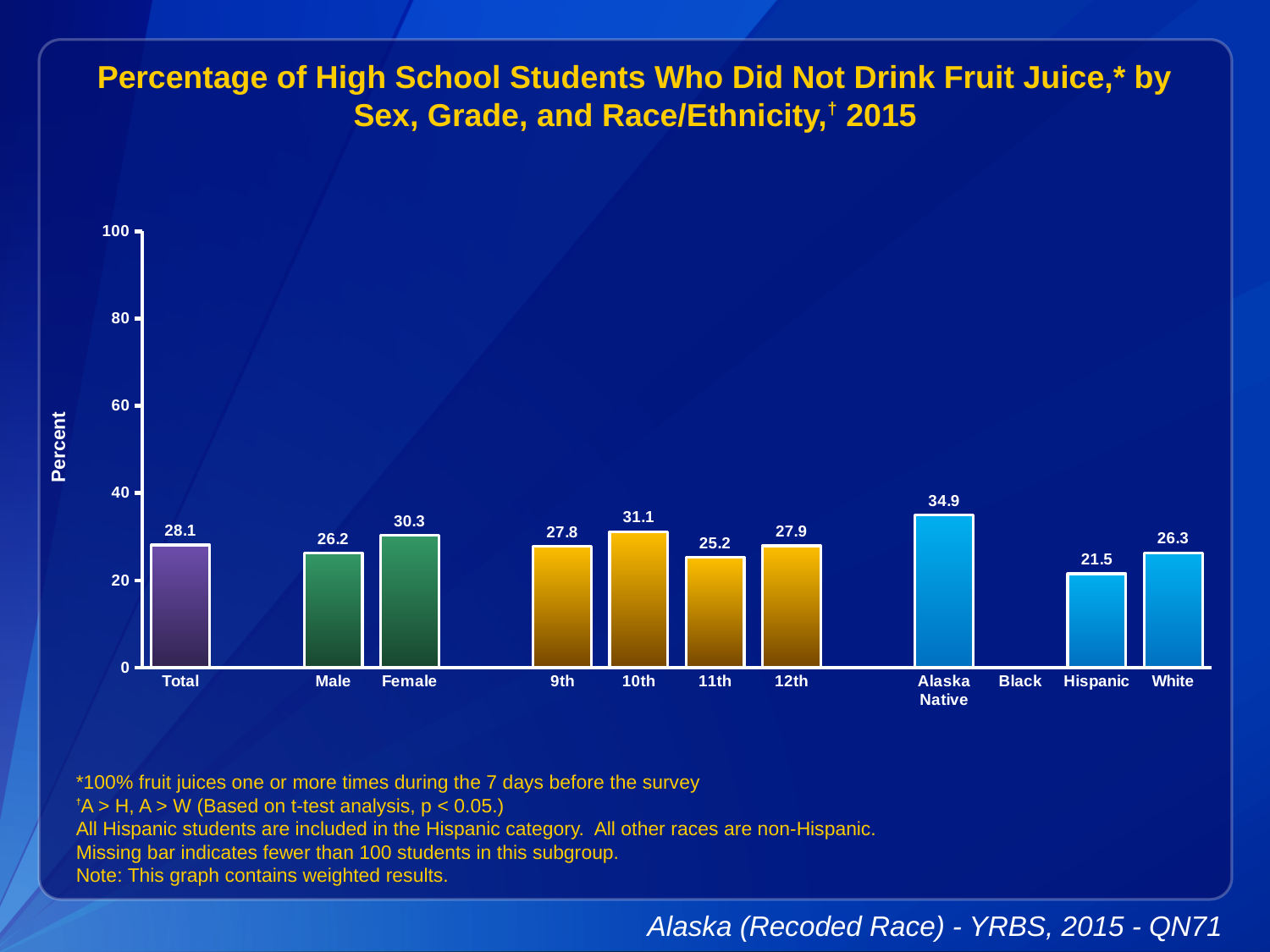
Is the value for White greater or less than 40? less What kind of chart is shown? bar chart What is the difference between the Female and Male values? 4.1 How many bars are plotted on the chart? 10 What is the value for Total? 28.1 What is the value for Alaska Native? 34.9 Which category label has no bar plotted? Black Which is larger, the value for 10th grade or 12th grade? 10th What is the value for Female? 30.3 What is the value for 11th grade? 25.2 Which category has the lowest value among the bars shown? Hispanic Which category has the highest value? Alaska Native